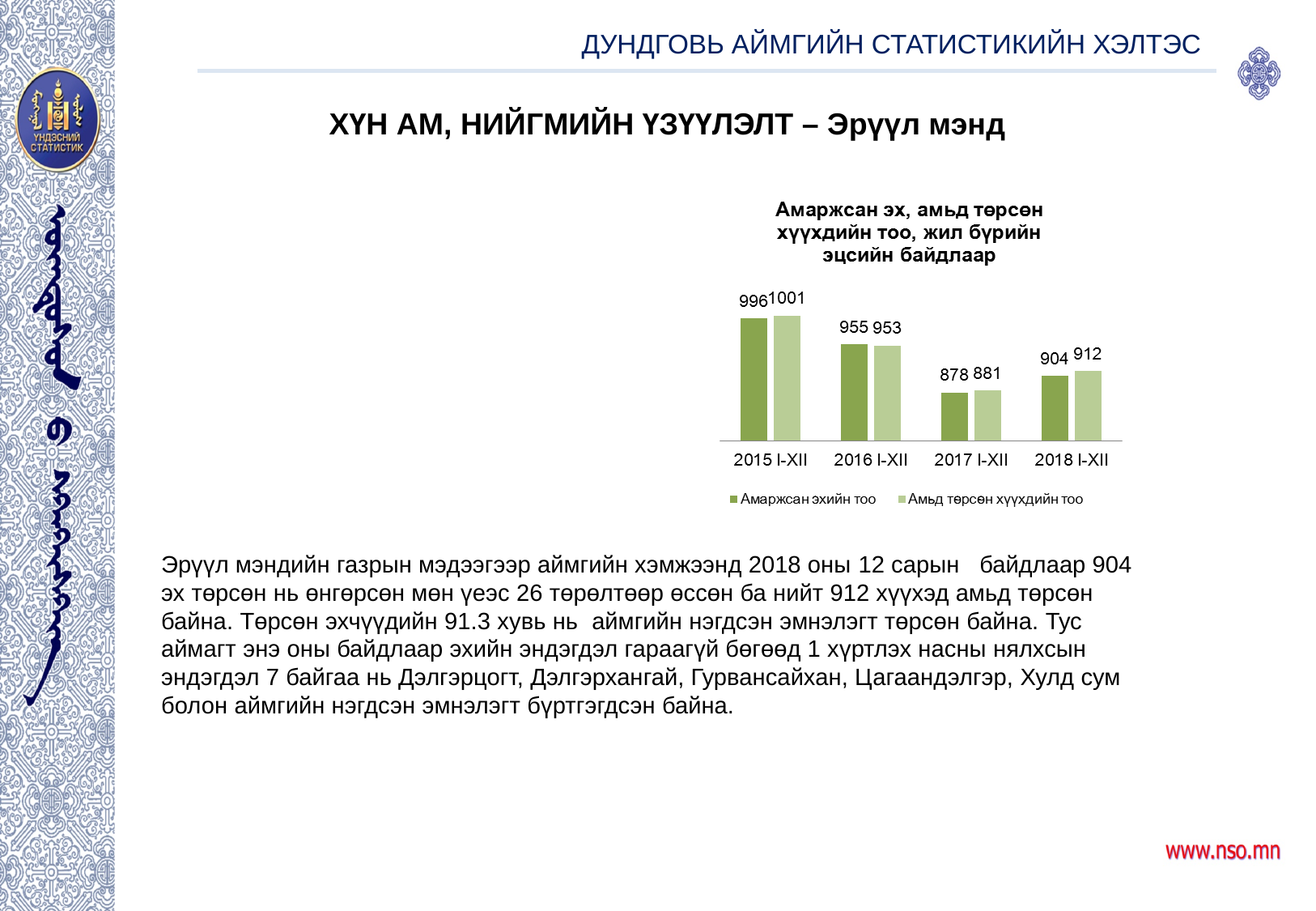
What is the difference in Амаржсан эхийн тоо between 2015 I-XII and 2016 I-XII? 41 What is the value of Амаржсан эхийн тоо for 2015 I-XII? 996 What is the difference between Амьд төрсөн хүүхдийн тоо and Амаржсан эхийн тоо in 2018 I-XII? 8 Which year has the highest value for Амаржсан эхийн тоо? 2015 I-XII How many years (categories) are shown on the x axis of the chart? 4 Which is larger in 2016 I-XII: Амаржсан эхийн тоо or Амьд төрсөн хүүхдийн тоо? Амаржсан эхийн тоо Does Амаржсан эхийн тоо rise or fall from 2015 I-XII to 2017 I-XII? Fall Which year has the lowest value for Амьд төрсөн хүүхдийн тоо? 2017 I-XII What is the value of Амьд төрсөн хүүхдийн тоо for 2017 I-XII? 881 What kind of chart is shown on the slide? Bar chart How many series does the chart legend list? 2 What is the value of Амьд төрсөн хүүхдийн тоо for 2018 I-XII? 912